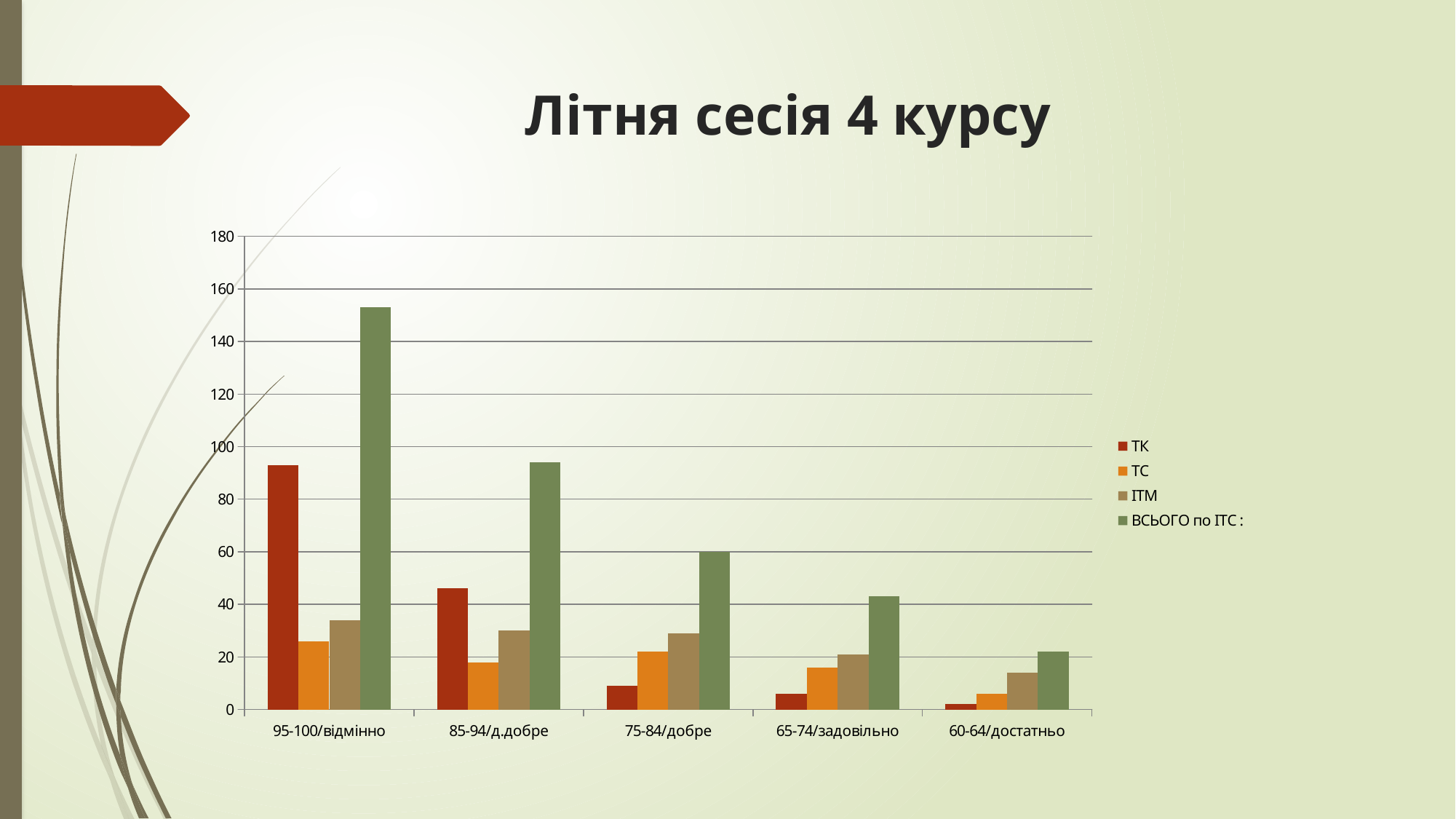
In the 75-84/добре category, which is larger: ТК or ІТМ? ІТМ What kind of chart is shown on the slide? bar chart Is the value for ТК in the 95-100/відмінно category greater or less than 80? greater How many grade categories are shown on the x axis? 5 Is the value for ВСЬОГО по ІТС in the 85-94/д.добре category greater or less than 100? less Which category has the highest value for the ВСЬОГО по ІТС series? 95-100/відмінно Is the value for ВСЬОГО по ІТС in the 95-100/відмінно category greater or less than 140? greater What is the title of the slide? Літня сесія 4 курсу How many series does the legend list? 4 Which category has the lowest value for the ТК series? 60-64/достатньо Do the values for the ВСЬОГО по ІТС series rise or fall from left to right along the x axis? fall